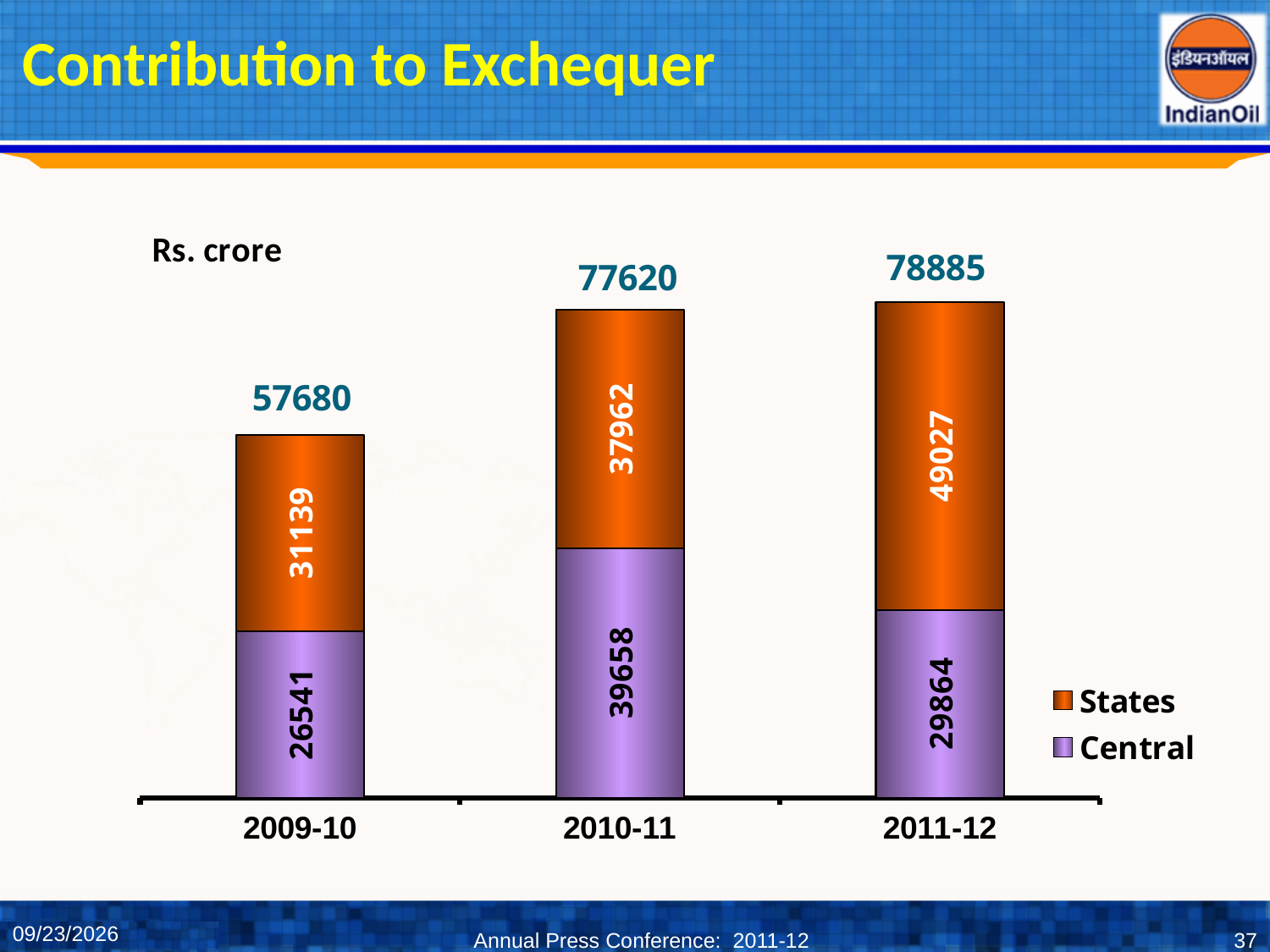
What is the Central contribution for 2009-10? 26541 Which year has the highest total contribution to exchequer? 2011-12 Which is larger in 2011-12, the States contribution or the Central contribution? States What is the difference between the States contribution in 2011-12 and in 2010-11? 11065 What is the Central contribution for 2010-11? 39658 What kind of chart is shown on the slide? Stacked bar chart What is the States contribution for 2011-12? 49027 How many series does the legend list? 2 How many years are shown on the x axis? 3 What is the total contribution to exchequer for 2010-11? 77620 What unit is stated for the values in the chart? Rs. crore Which year has the lowest States contribution? 2009-10